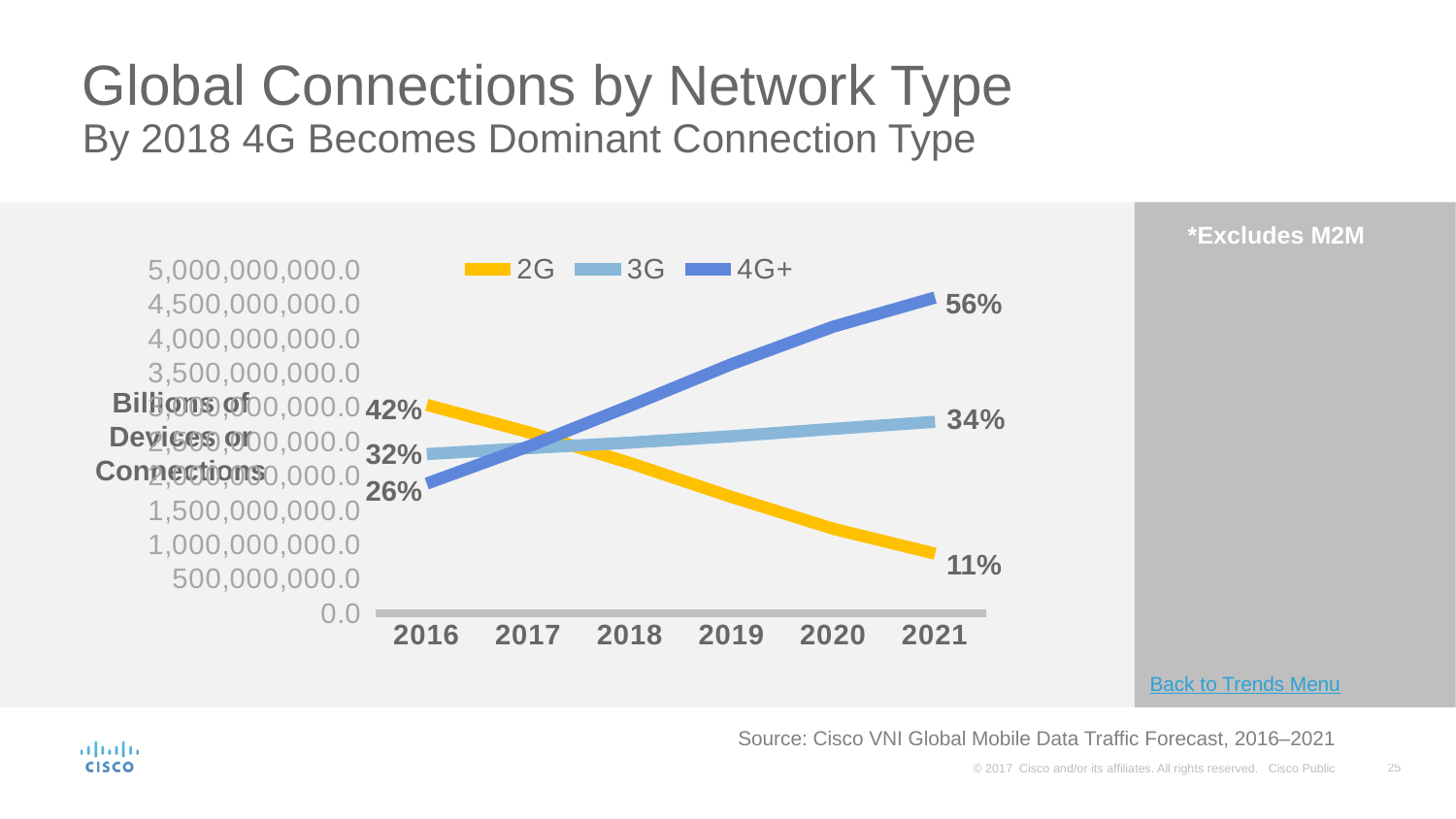
How many years are shown on the x axis of the chart? 6 What percentage label is shown for 4G+ in 2021? 56% Is the value for 4G+ in 2021 greater or less than 4,000,000,000.0? greater What kind of chart is shown on the slide? Line chart What is the difference in percentage points between the 4G+ label and the 2G label in 2021? 45 percentage points Does the 2G line rise or fall from 2016 to 2021? Fall What percentage label is shown for 3G in 2021? 34% How many series does the chart legend list? 3 What percentage label is shown for 2G in 2016? 42% Which network type has the lowest number of connections in 2016? 4G+ What percentage label is shown for 4G+ in 2016? 26% Which network type has the highest number of connections in 2021? 4G+